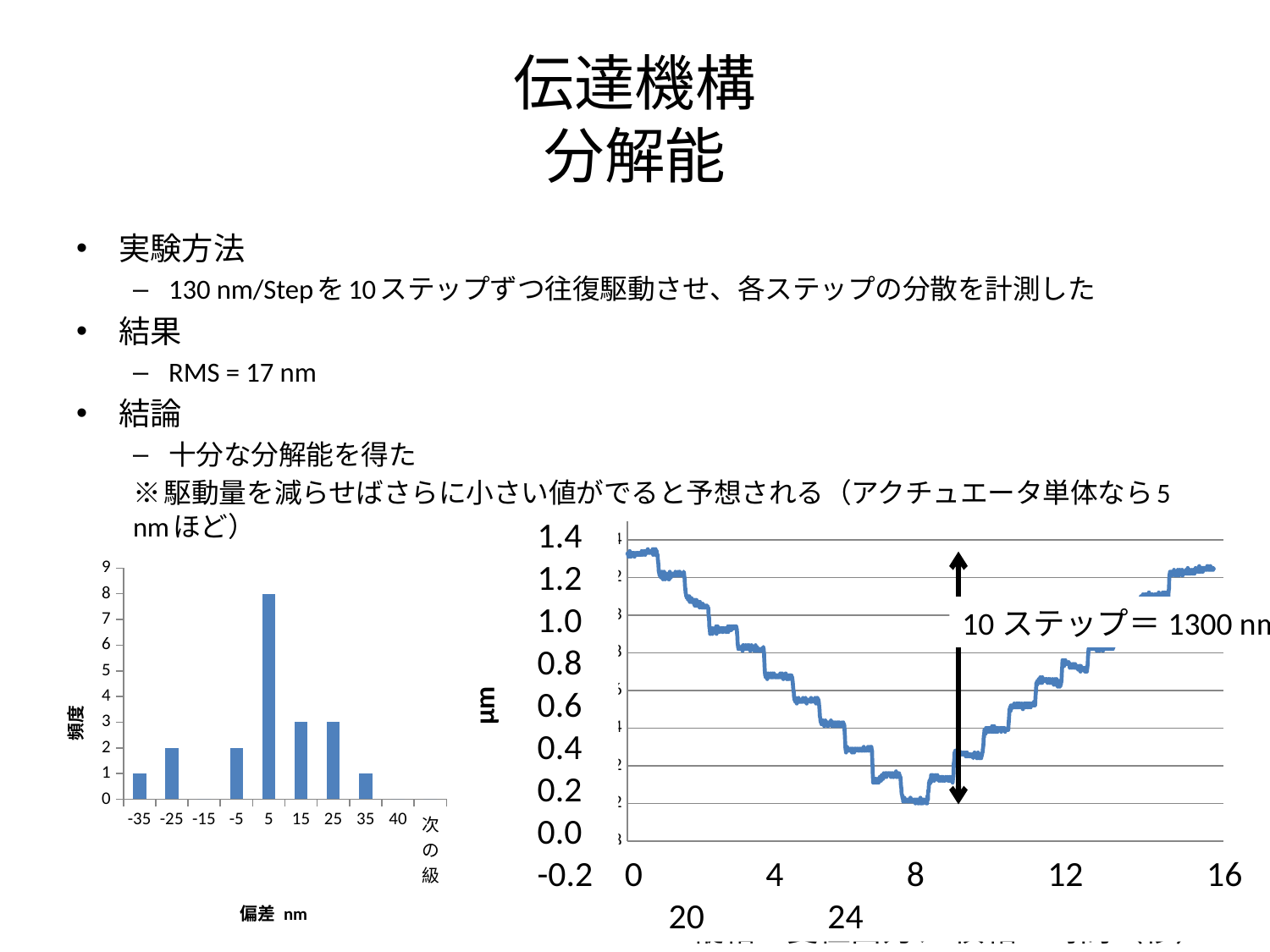
In the right line chart, is the value at x = 8 greater or less than 0.6 µm? less In the left bar chart, what is the 頻度 for the 偏差 category 5? 8 In the left bar chart, what is the difference in 頻度 between the 偏差 categories 5 and 25? 5 In the right line chart, do the values rise or fall along the x axis between x = 0 and x = 8? fall What kind of chart is the left chart (偏差 nm on the x axis)? bar chart In the left bar chart, which 偏差 category has the highest 頻度? 5 In the left bar chart, which is larger, the 頻度 for 偏差 -35 or for 偏差 -5? -5 In the left bar chart, what is the label of the y axis? 頻度 In the left bar chart, what is the 頻度 for the 偏差 category -25? 2 What kind of chart is the right chart (µm on the y axis)? line chart In the left bar chart, what is the 頻度 for the 偏差 category 15? 3 In the right line chart, what does the annotation next to the vertical arrow say? 10 ステップ= 1300 nm